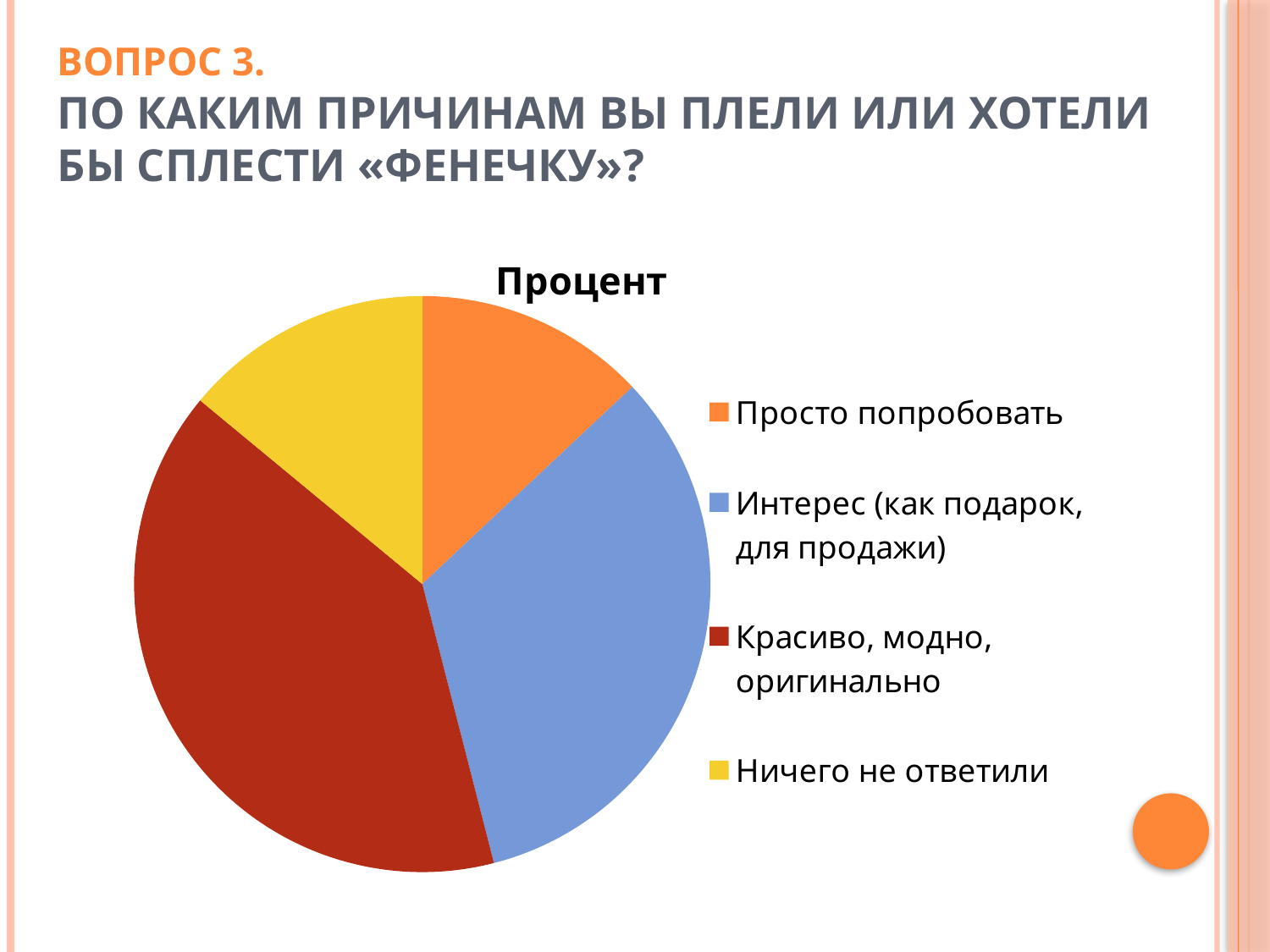
What is the title of the chart? Процент Which category has the largest slice of the pie? Красиво, модно, оригинально How many slices does the pie chart have? 4 Which slice is larger: "Интерес (как подарок, для продажи)" or "Просто попробовать"? Интерес (как подарок, для продажи) How many entries does the legend list? 4 Which colour represents "Ничего не ответили" in the pie chart? yellow Which slice is larger: "Интерес (как подарок, для продажи)" or "Ничего не ответили"? Интерес (как подарок, для продажи) Which slice is larger: "Красиво, модно, оригинально" or "Интерес (как подарок, для продажи)"? Красиво, модно, оригинально What kind of chart is shown on the slide? pie chart